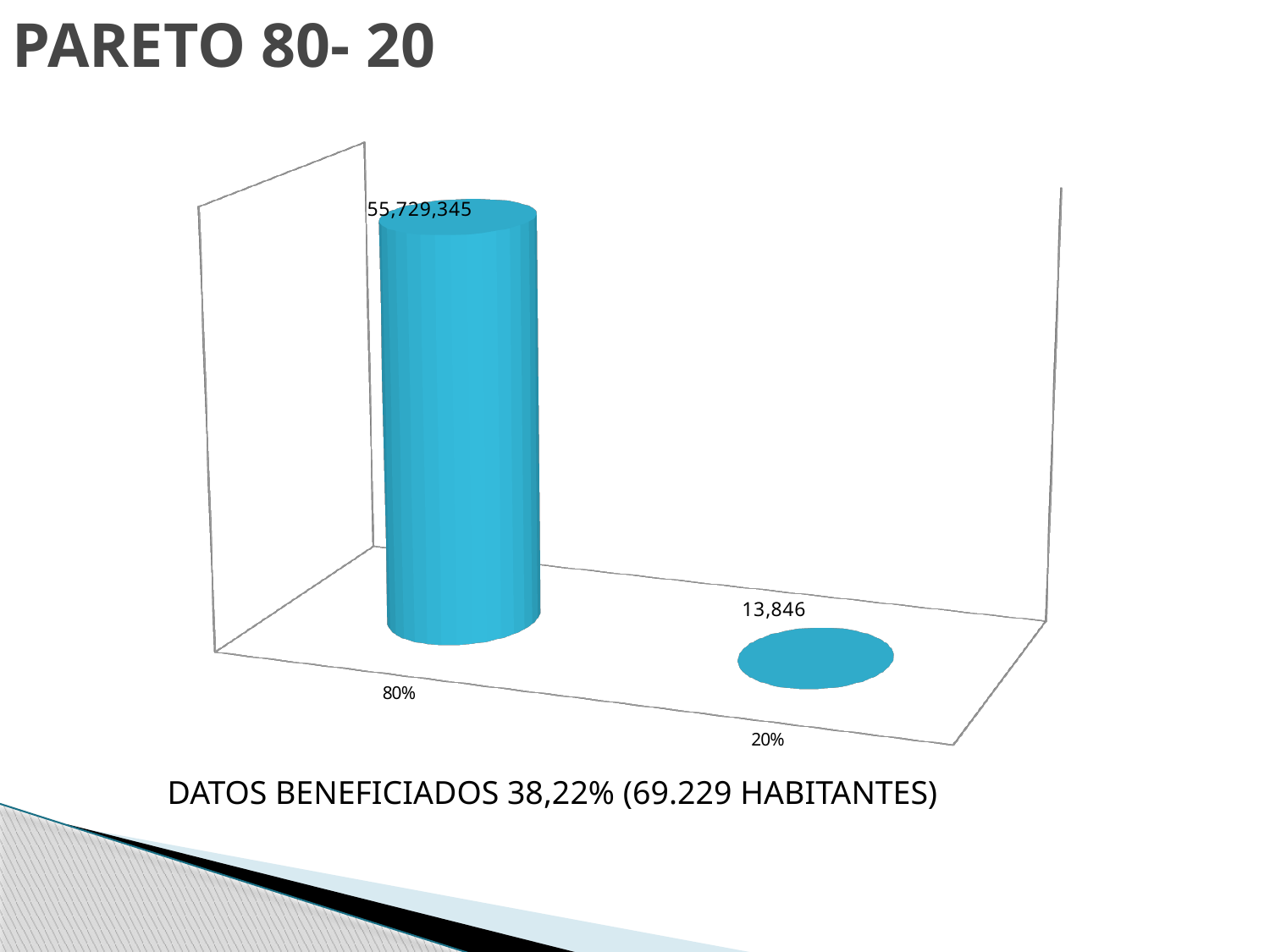
Do the values rise or fall from the 80% category to the 20% category? Fall Which category has the highest value? 80% What is the value shown for the 20% category? 13,846 What is the value shown for the 80% category? 55,729,345 What kind of chart is shown on the slide? Bar chart What is the title of the slide containing the chart? PARETO 80- 20 Which is larger, the value for 80% or the value for 20%? 80% What is the difference between the values for the 80% and 20% categories? 55,715,499 What colour are the bars in the chart? Blue Which category has the lowest value? 20% How many categories are plotted on the chart? 2